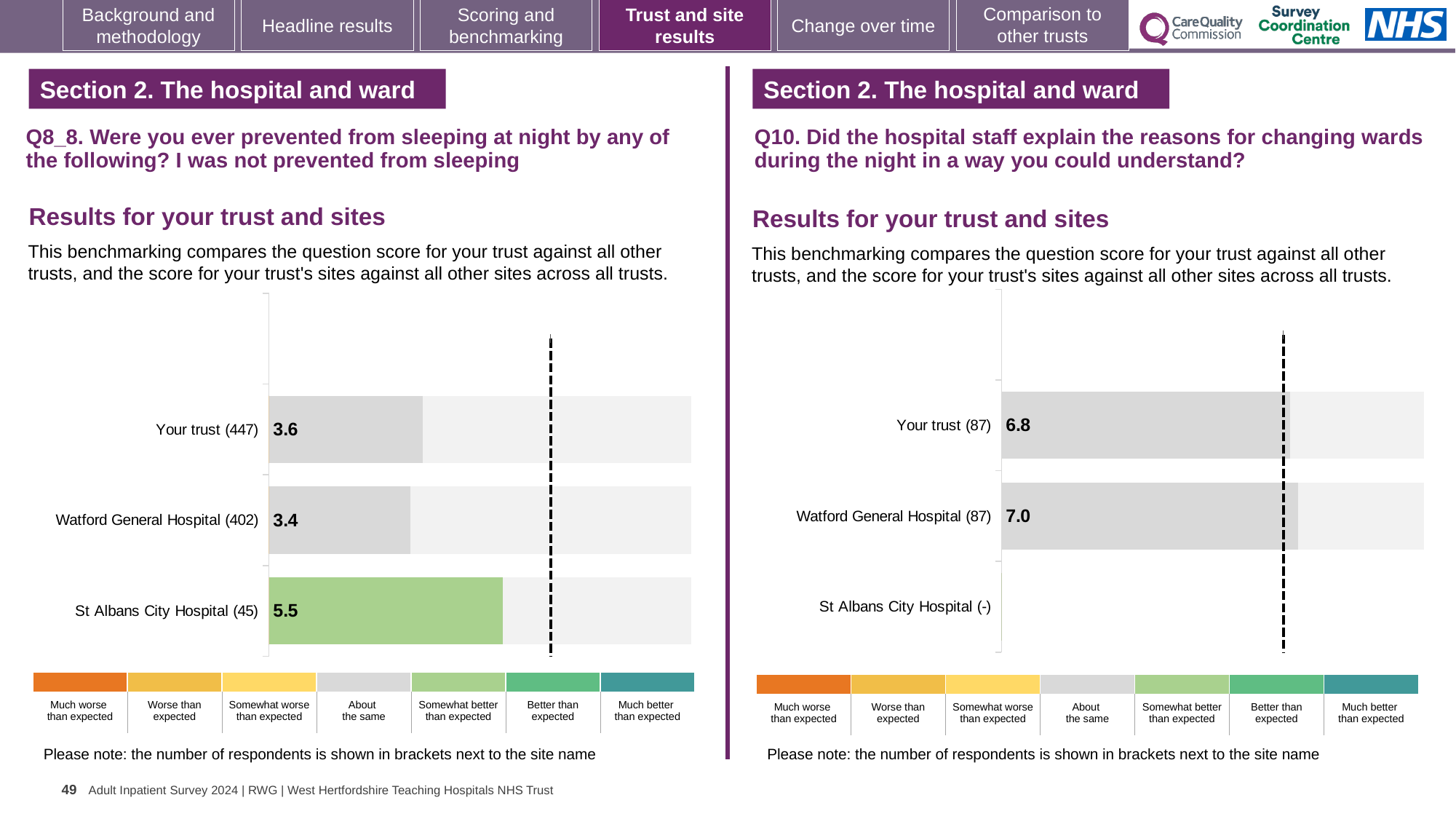
On the right chart (Q10), what is the score for Watford General Hospital? 7.0 On the left chart (Q8_8), what is the score for Watford General Hospital? 3.4 On the left chart (Q8_8), which site has the highest score? St Albans City Hospital On the right chart (Q10), what is the score for Your trust? 6.8 On the left chart (Q8_8), what is the difference between the St Albans City Hospital score and the Watford General Hospital score? 2.1 On the left chart (Q8_8), which benchmark category does the green bar for St Albans City Hospital represent? Somewhat better than expected On the left chart (Q8_8), how many respondents are shown for Your trust? 447 On the left chart (Q8_8), what is the score for St Albans City Hospital? 5.5 On the left chart (Q8_8), what is the score for Your trust? 3.6 On the right chart (Q10), how many rows (trust and sites) are listed? 3 On the right chart (Q10), which is larger: the score for Watford General Hospital or the score for Your trust? Watford General Hospital What kind of chart is used on the left (Q8_8)? Bar chart